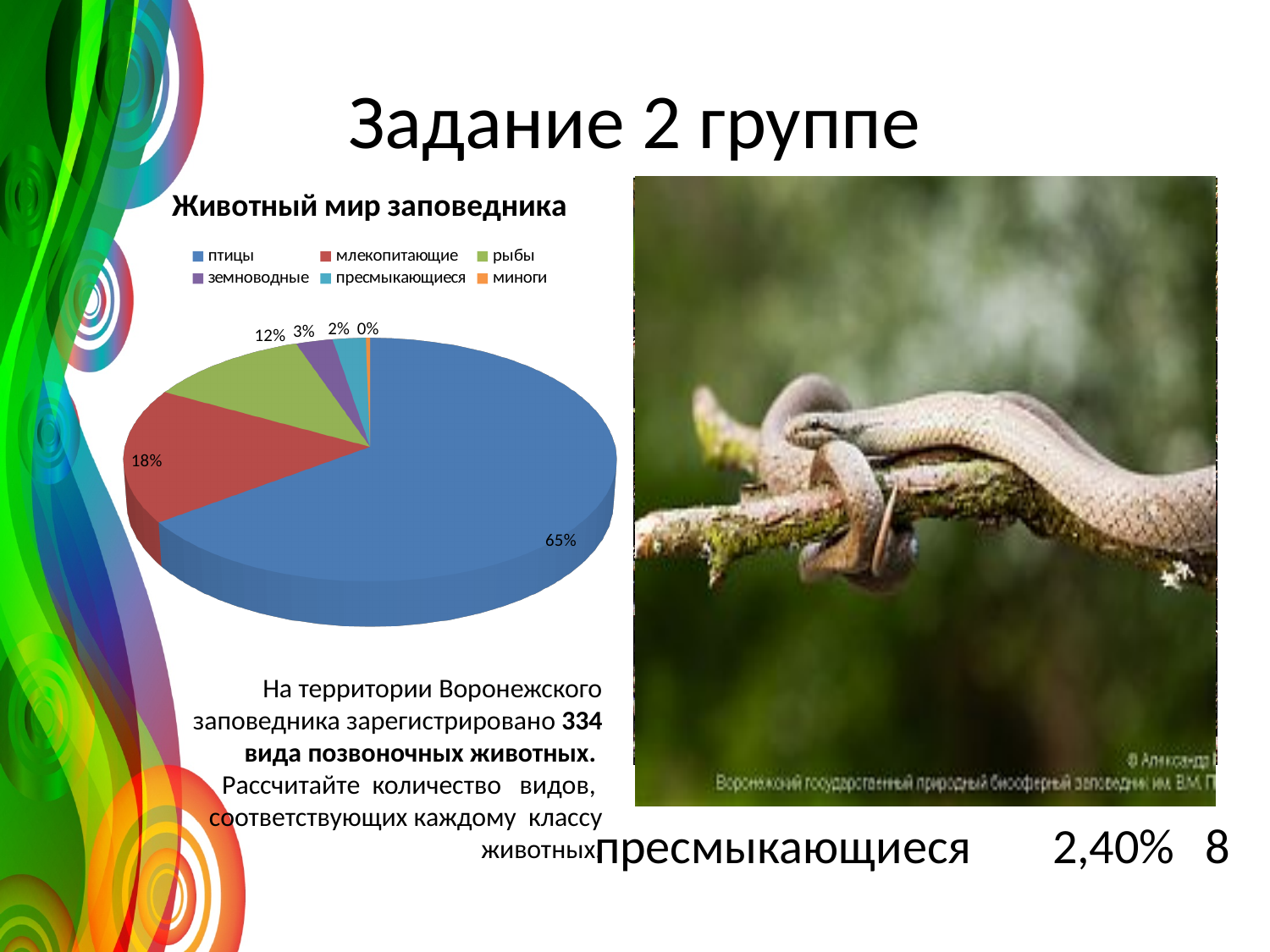
What is the title of the chart? Животный мир заповедника What type of chart is shown on the slide? pie chart What share of the pie chart is labelled for пресмыкающиеся? 2% Which category has the largest slice in the pie chart? птицы What share of the pie chart is labelled for земноводные? 3% Which has a larger share, рыбы or земноводные? рыбы What share of the pie chart is labelled for рыбы? 12% What is the difference between the shares of птицы and млекопитающие? 47% Which category has the smallest slice in the pie chart? миноги How many categories does the legend of the pie chart list? 6